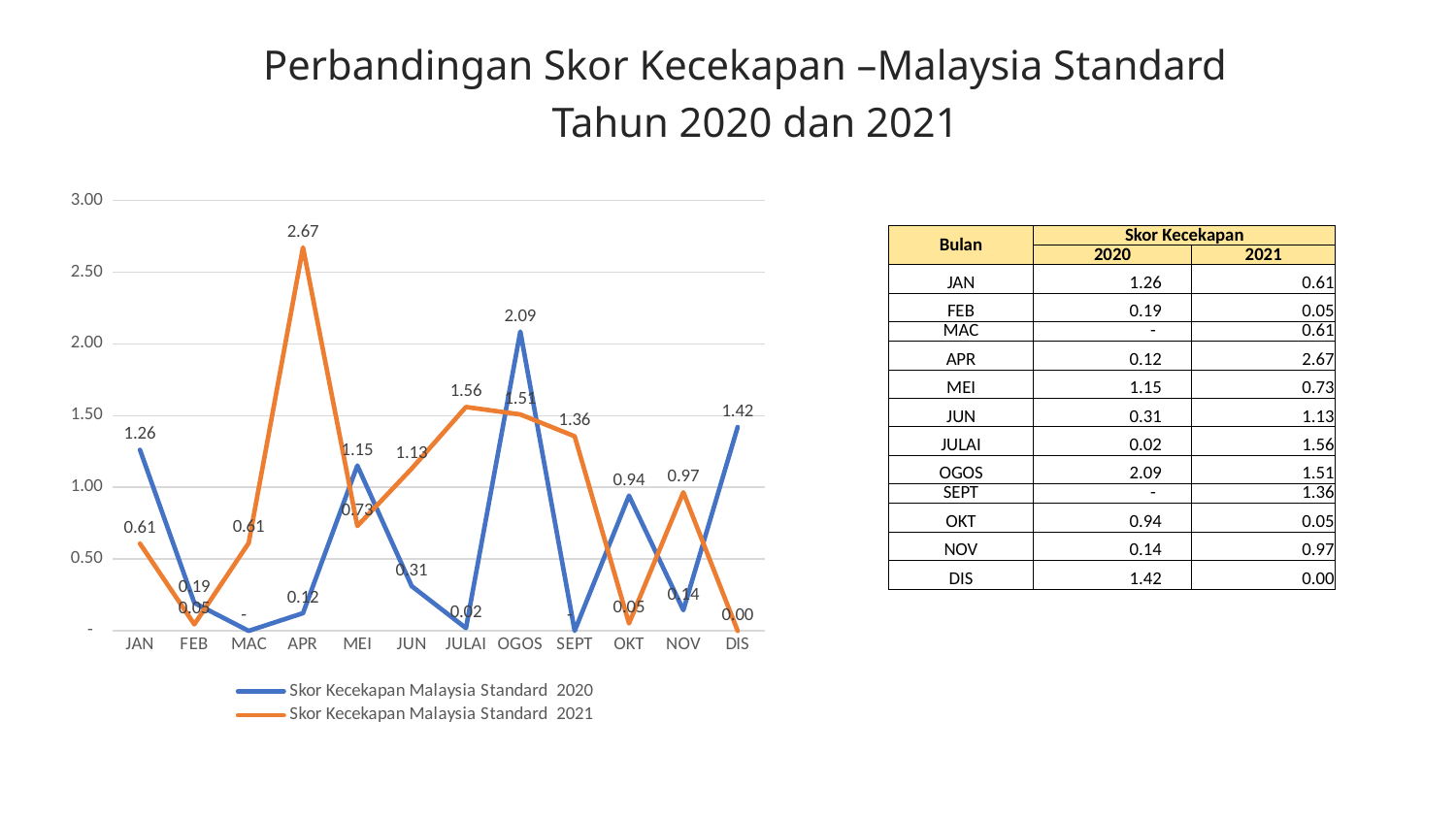
For JULAI, which series has the larger value, 2020 or 2021? 2021 What is the difference between the 2021 and 2020 values for APR? 2.55 What type of chart is shown on the slide? line chart In which month does the 2020 series reach its highest value? OGOS What is the Skor Kecekapan Malaysia Standard 2021 value for APR? 2.67 How many series does the chart legend list? 2 What is the Skor Kecekapan Malaysia Standard 2021 value for DIS? 0.00 How many months are plotted along the x axis of the chart? 12 What is the difference between the 2020 and 2021 values for JAN? 0.65 What is the Skor Kecekapan Malaysia Standard 2020 value for OGOS? 2.09 In which month does the 2021 series reach its highest value? APR Which series is drawn with the orange line? Skor Kecekapan Malaysia Standard 2021